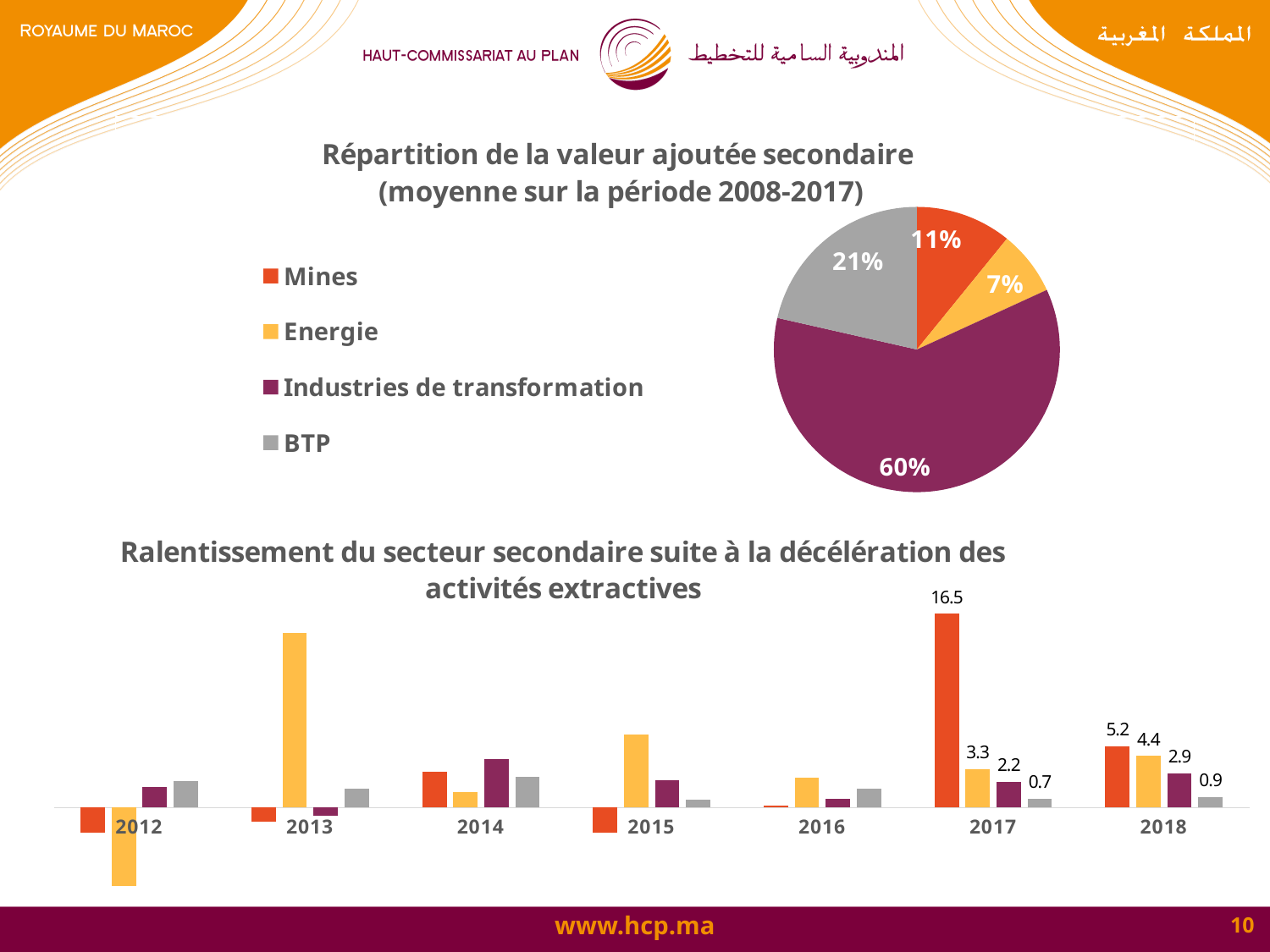
What kind of chart is the chart at the top of the slide? Pie chart In the pie chart 'Répartition de la valeur ajoutée secondaire', which category has the largest share? Industries de transformation In the pie chart 'Répartition de la valeur ajoutée secondaire', what share does Energie hold? 7% In the pie chart 'Répartition de la valeur ajoutée secondaire', what share does Industries de transformation hold? 60% In the pie chart 'Répartition de la valeur ajoutée secondaire', how many percentage points larger is the Mines share than the Energie share? 4 How many years are shown on the x axis of the bar chart at the bottom of the slide? 7 In the pie chart 'Répartition de la valeur ajoutée secondaire', which category has the smallest share? Energie In the pie chart 'Répartition de la valeur ajoutée secondaire', what share does BTP hold? 21% What kind of chart is the chart at the bottom of the slide? Bar chart In the bar chart at the bottom of the slide, what is the value of the grey bar for 2018? 0.9 In the bar chart at the bottom of the slide, what is the value of the orange bar for 2017? 16.5 How many categories does the legend of the pie chart 'Répartition de la valeur ajoutée secondaire' list? 4